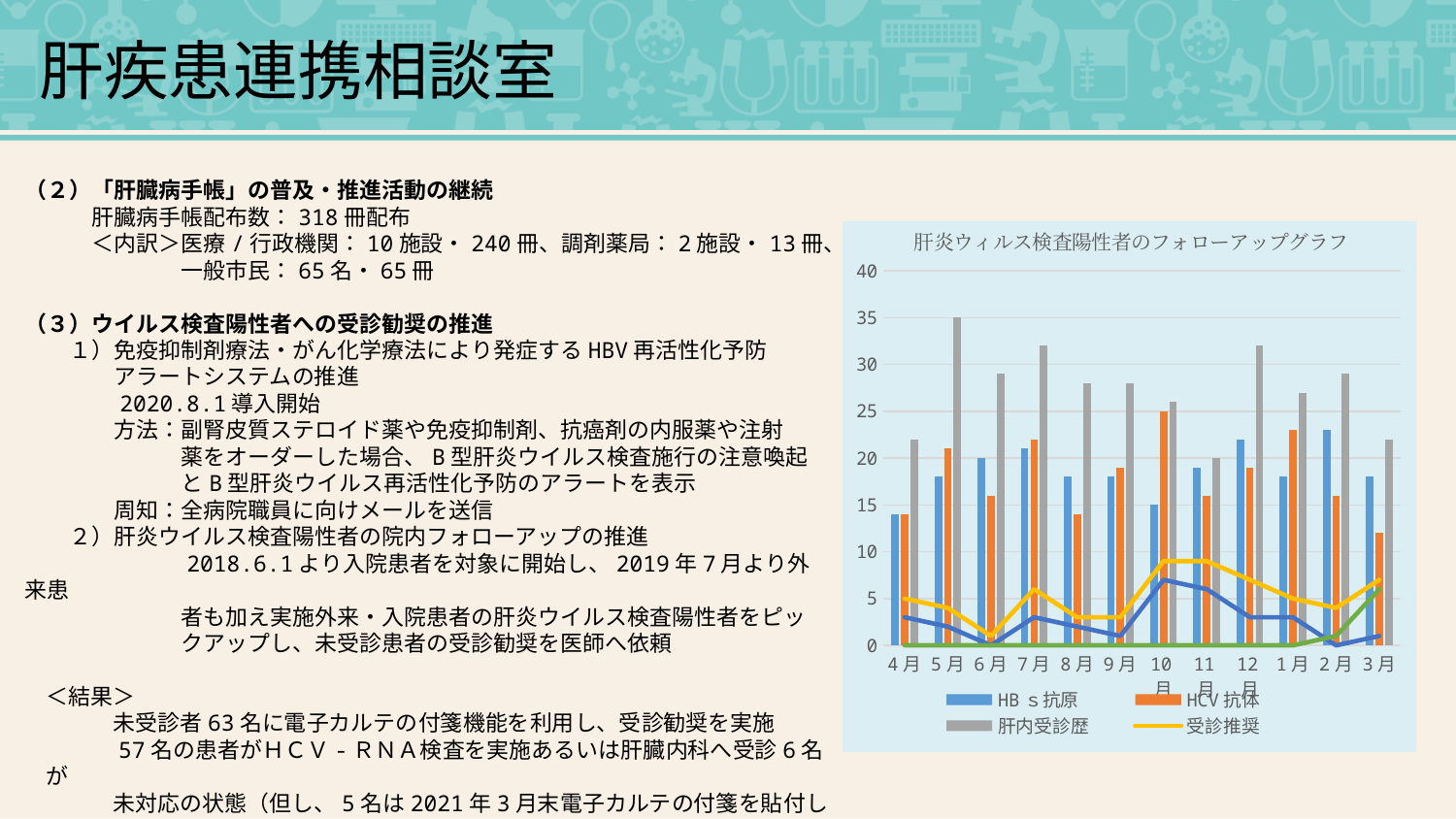
How many months (categories) are shown on the x axis of the chart? 12 In 5月, which is larger: the 肝内受診歴 bar or the HCV 抗体 bar? 肝内受診歴 Is the 受診推奨 value for 10月 greater or less than 5? greater Is the 肝内受診歴 value for 11月 greater or less than 25? less What is the title of the chart on the slide? 肝炎ウィルス検査陽性者のフォローアップグラフ In 10月, which is larger: the HCV 抗体 bar or the HB s 抗原 bar? HCV 抗体 What kind of chart is shown on the slide? A combined bar and line chart Is the HCV 抗体 value for 10月 greater or less than 20? greater In which month is the 肝内受診歴 bar the highest? 5月 In which month is the HCV 抗体 bar the highest? 10月